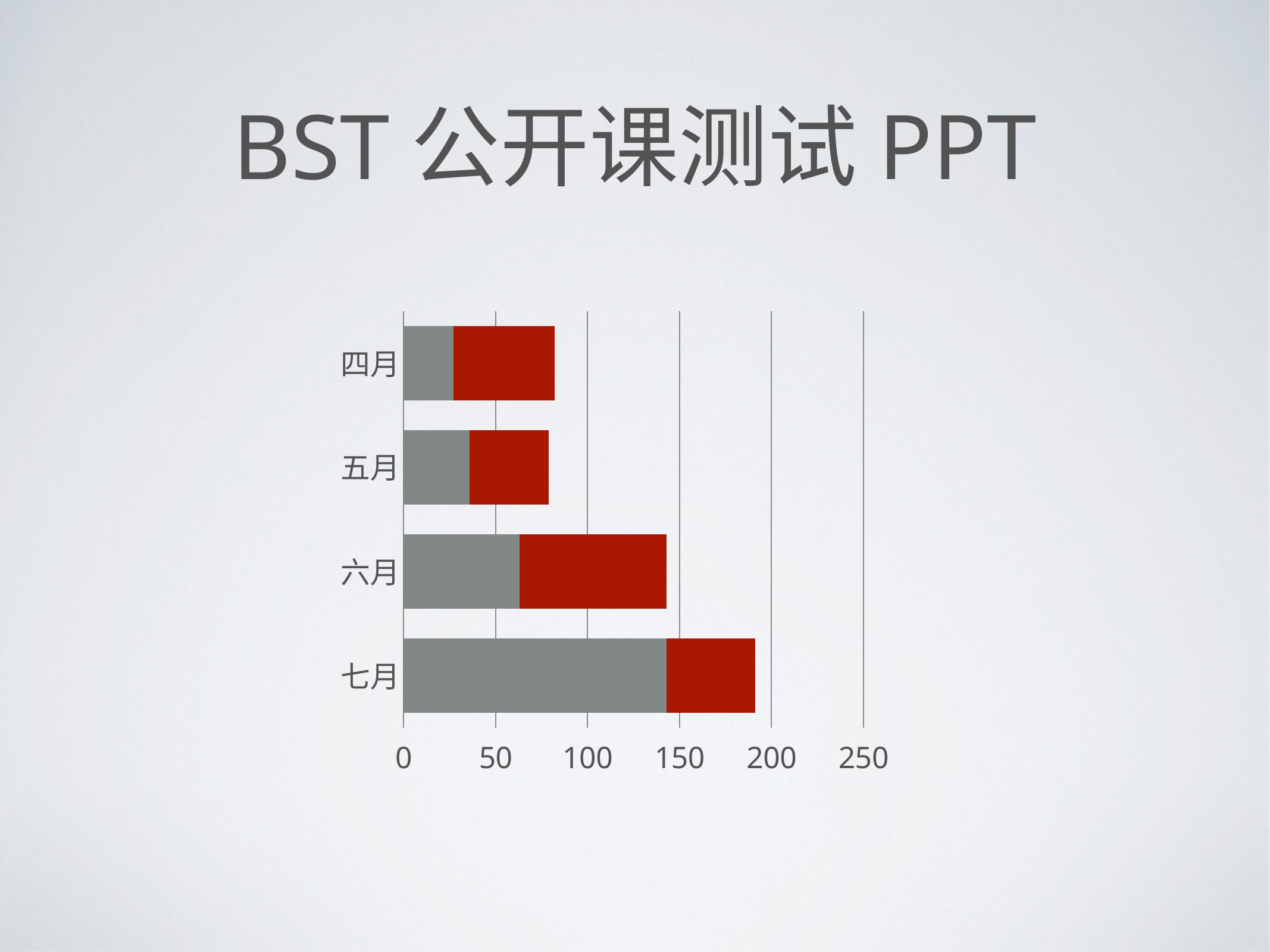
Is the total bar for 五月 greater or less than 100? less Is the total bar for 四月 greater or less than 50? greater Is the total bar for 七月 greater or less than 150? greater What two colours are used for the bar segments? Grey and red How many categories (months) are shown on the chart? 4 What is the highest value shown on the horizontal axis? 250 What kind of chart is shown on the slide? Stacked bar chart Which has the longer total bar, 六月 or 四月? 六月 Which has the longer total bar, 七月 or 六月? 七月 Which month has the longest total bar? 七月